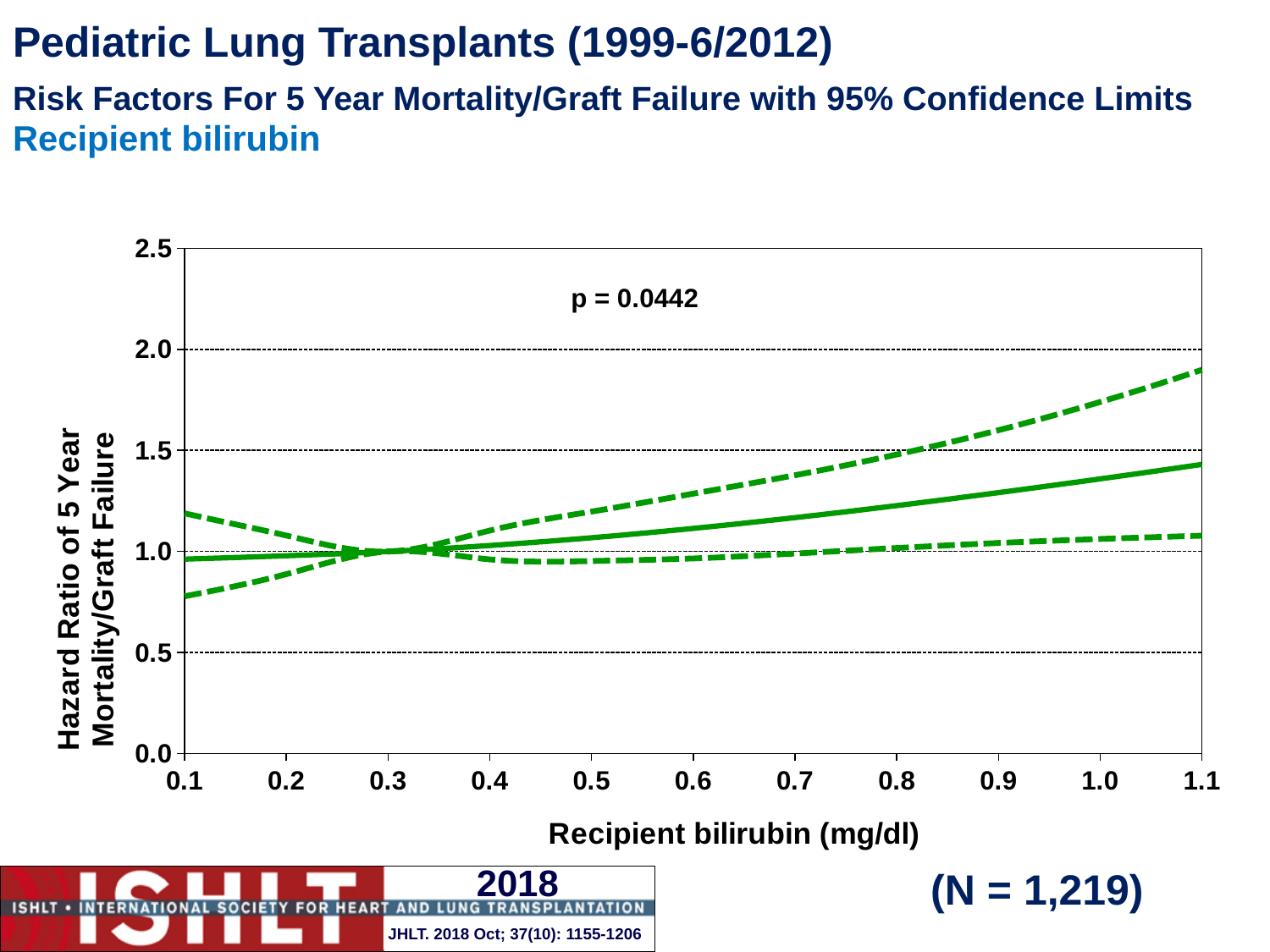
Is the upper dashed confidence limit at a recipient bilirubin of 1.1 mg/dl greater or less than 2.0? less What p-value is printed on the chart? p = 0.0442 Is the solid hazard ratio line at a recipient bilirubin of 1.1 mg/dl greater or less than 1.5? less How many tick labels are shown on the x axis of the chart? 11 Is the solid hazard ratio line at a recipient bilirubin of 1.1 mg/dl greater or less than 1.0? greater What is the label of the x axis of the chart? Recipient bilirubin (mg/dl) What kind of chart is shown on the slide? line chart How many lines are plotted on the chart? 3 Does the solid hazard ratio line rise or fall as recipient bilirubin increases from 0.3 to 1.1 mg/dl? rise